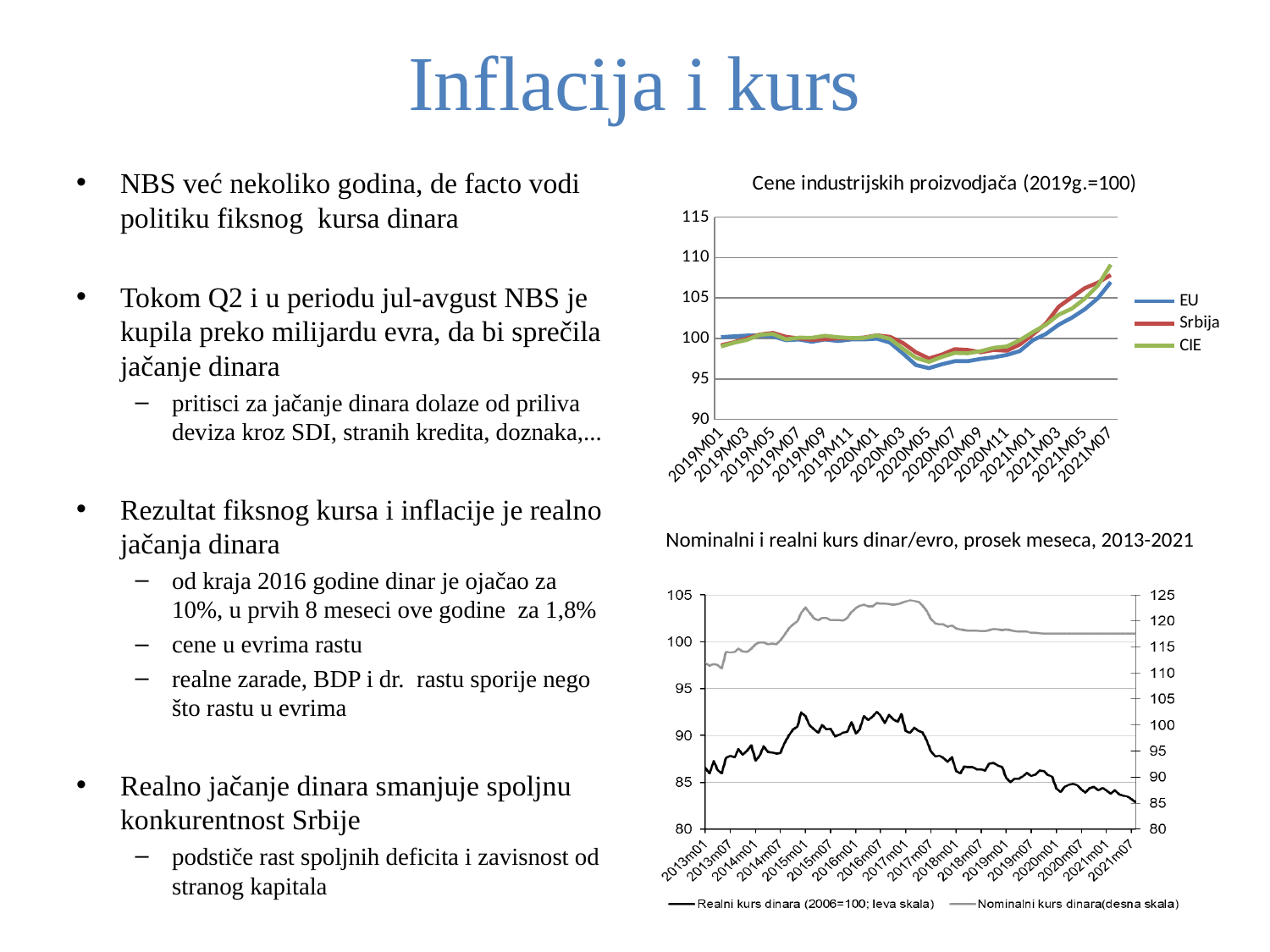
In the bottom chart 'Nominalni i realni kurs dinar/evro', does 'Realni kurs dinara' rise or fall between 2017m07 and 2021m07? fall What kind of chart is the bottom chart titled 'Nominalni i realni kurs dinar/evro, prosek meseca, 2013-2021'? line chart In the bottom chart 'Nominalni i realni kurs dinar/evro', is the value of 'Nominalni kurs dinara' at 2021m07 greater or less than 120 on the right scale? less In the top chart 'Cene industrijskih proizvodjača', do the values for CIE rise or fall between 2020M05 and 2021M07? rise In the bottom chart 'Nominalni i realni kurs dinar/evro', is the value of 'Realni kurs dinara' at 2013m01 greater or less than 90 on the left scale? less How many series does the legend of the bottom chart 'Nominalni i realni kurs dinar/evro' list? 2 In the top chart 'Cene industrijskih proizvodjača', which series are listed in the legend? EU, Srbija, CIE In the top chart 'Cene industrijskih proizvodjača', is the value for Srbija at 2021M07 greater or less than 105? greater In the bottom chart 'Nominalni i realni kurs dinar/evro', which series is plotted on the right scale according to the legend? Nominalni kurs dinara What kind of chart is the top chart titled 'Cene industrijskih proizvodjača (2019g.=100)'? line chart How many series does the legend of the top chart 'Cene industrijskih proizvodjača' list? 3